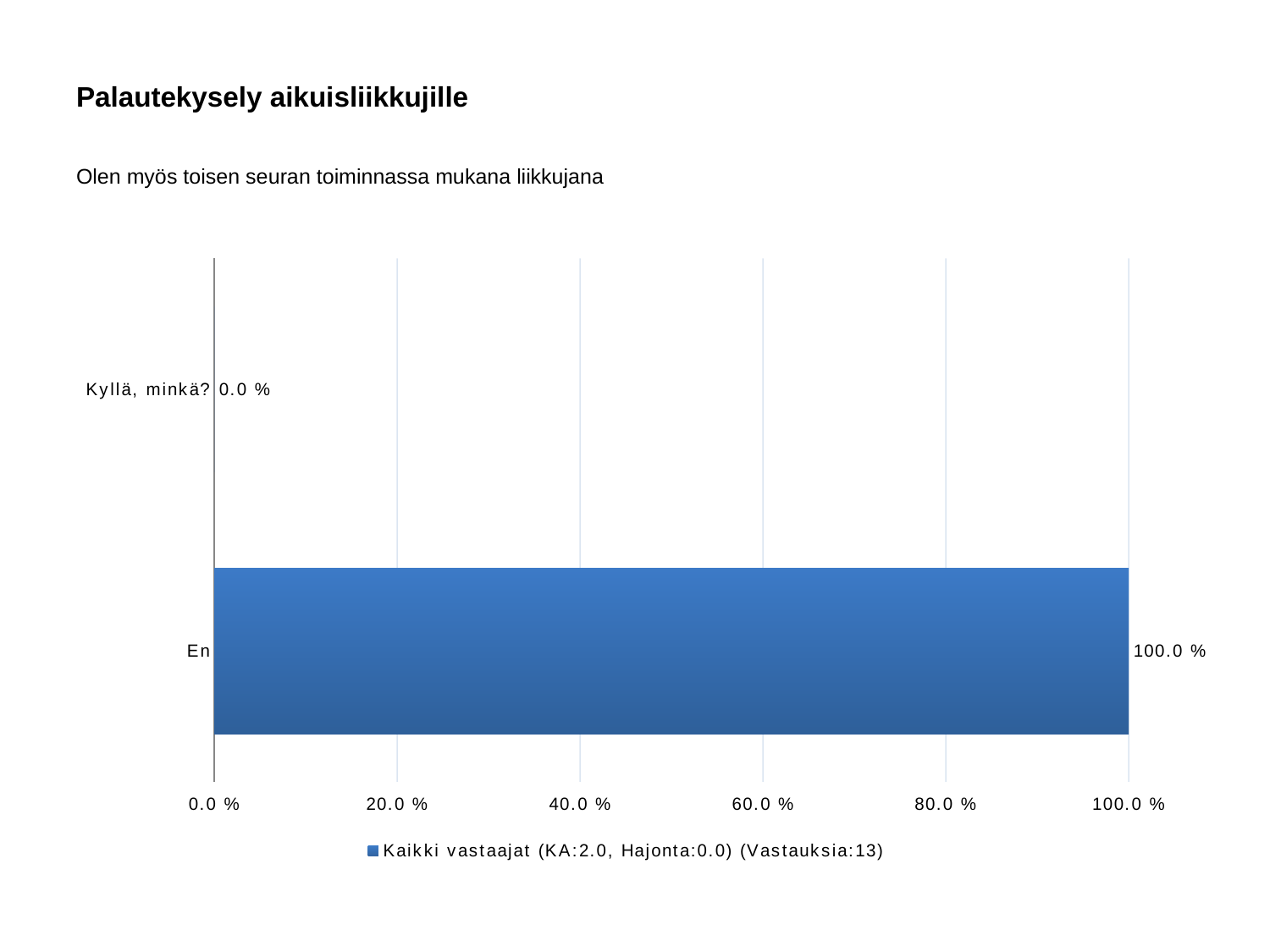
Which category has the lowest value? Kyllä, minkä? What is the value for "En"? 100.0 % What kind of chart is shown on the slide? bar chart What is the difference between the values for "En" and "Kyllä, minkä?"? 100.0 % What is the value for "Kyllä, minkä?"? 0.0 % Is the value for "En" greater or less than 80.0 %? greater Which category has the highest value? En What is the legend entry of the chart? Kaikki vastaajat (KA:2.0, Hajonta:0.0) (Vastauksia:13) How many categories are shown on the chart? 2 How many series does the legend list? 1 Which is larger, the value for "En" or the value for "Kyllä, minkä?"? En What is the title of the slide? Palautekysely aikuisliikkujille